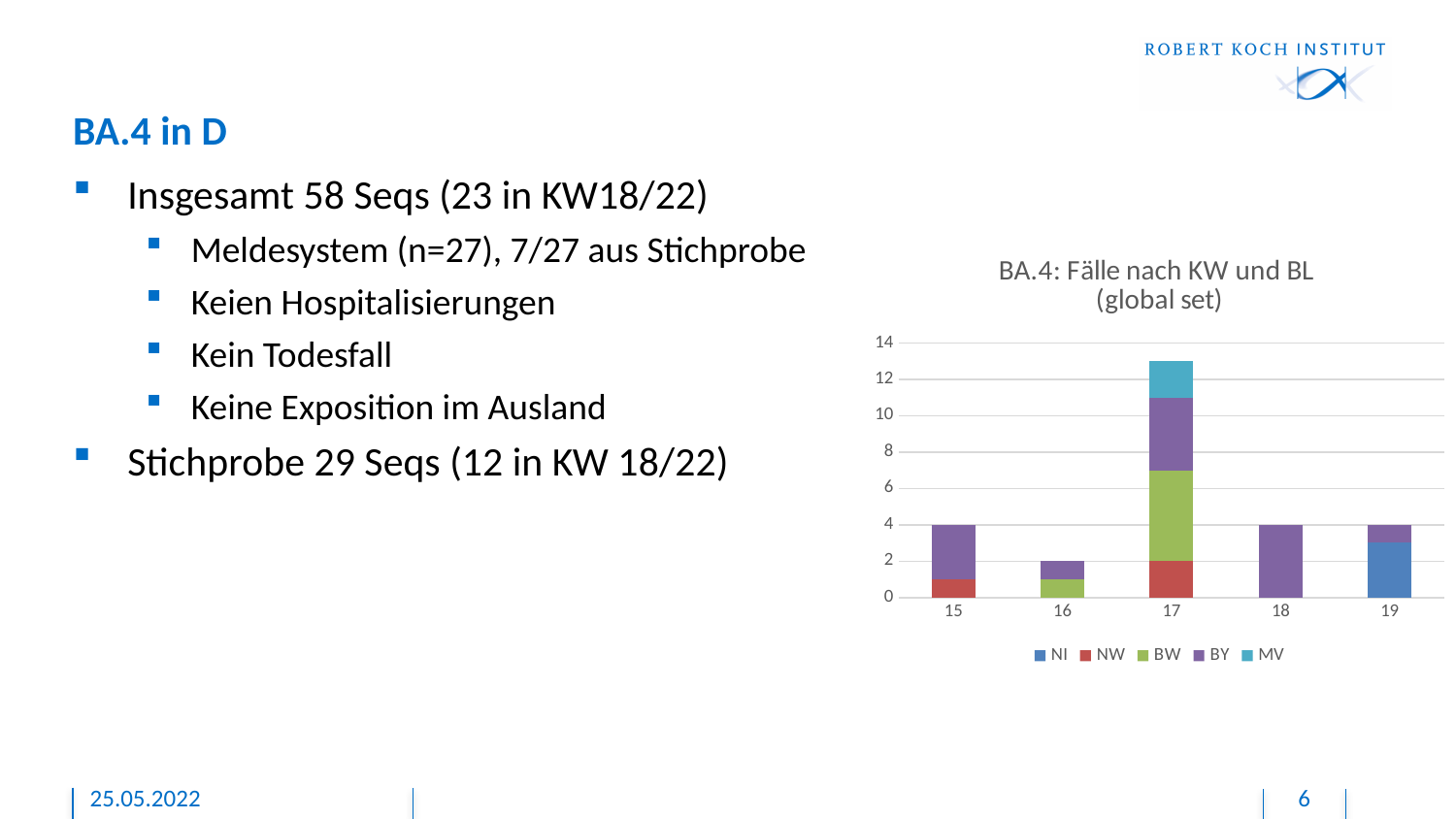
Which calendar week has the highest total bar in the chart? 17 Which series in the legend is shown in light blue (the top segment of the bar for week 17)? MV Is the total value for calendar week 16 greater or less than 4? less What is the title of the chart? BA.4: Fälle nach KW und BL (global set) How many calendar weeks (categories) are shown on the x axis of the chart? 5 Which calendar week has the lowest total bar in the chart? 16 What kind of chart is shown on the slide? bar chart What is the total of the stacked bar for calendar week 16? 2 What is the total of the stacked bar for calendar week 18? 4 Is the total value for calendar week 17 greater or less than 12? greater How many series does the chart legend list? 5 Which is larger, the total bar for calendar week 17 or for calendar week 15? 17